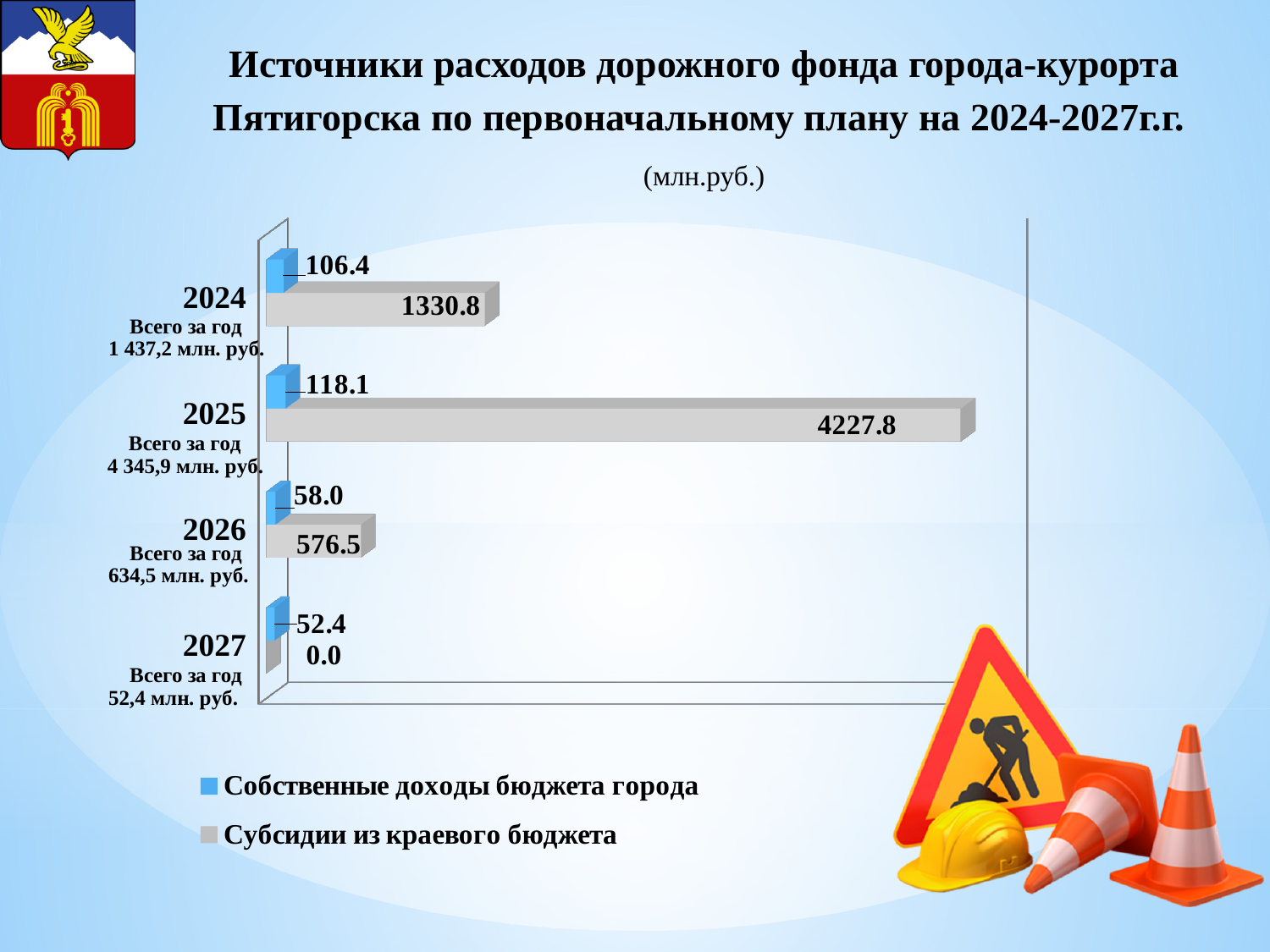
What is the value of Собственные доходы бюджета города for 2024? 106.4 Which year has the highest value for Субсидии из краевого бюджета? 2025 What kind of chart is shown on the slide? Bar chart Which year has the lowest value for Собственные доходы бюджета города? 2027 How many years are shown in the chart? 4 How many series does the legend list? 2 What is the value of Субсидии из краевого бюджета for 2027? 0.0 Which is larger: Субсидии из краевого бюджета in 2024 or in 2026? 2024 Which colour represents Субсидии из краевого бюджета in the chart? Grey What is the difference between Собственные доходы бюджета города in 2025 and in 2024? 11.7 What is the value of Собственные доходы бюджета города for 2026? 58.0 What is the value of Субсидии из краевого бюджета for 2025? 4227.8